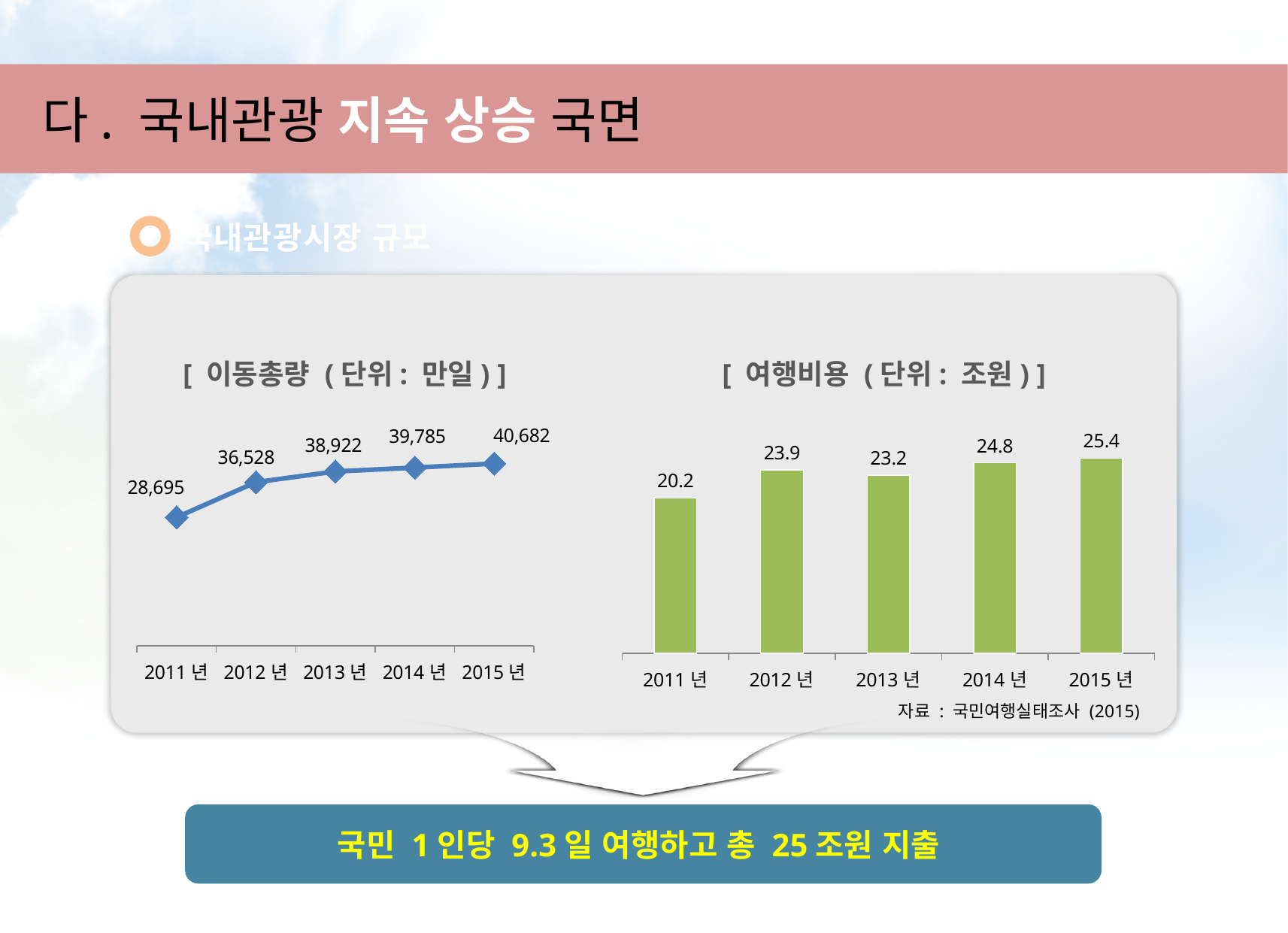
In the right chart (여행비용), what is the value for 2013년? 23.2 How many years are shown in the right chart (여행비용)? 5 What kind of chart is the left chart (이동총량)? line chart In the left chart (이동총량), what is the value for 2011년? 28,695 What kind of chart is the right chart (여행비용)? bar chart In the left chart (이동총량), what is the difference between the 2012년 and 2011년 values? 7,833 In the left chart (이동총량), do the values rise or fall from 2011년 to 2015년? rise In the right chart (여행비용), which is larger, the value for 2012년 or 2013년? 2012년 In the left chart (이동총량), which year has the lowest value? 2011년 In the right chart (여행비용), what is the difference between the 2015년 and 2011년 values? 5.2 In the right chart (여행비용), which year has the highest value? 2015년 In the left chart (이동총량), what is the value for 2015년? 40,682